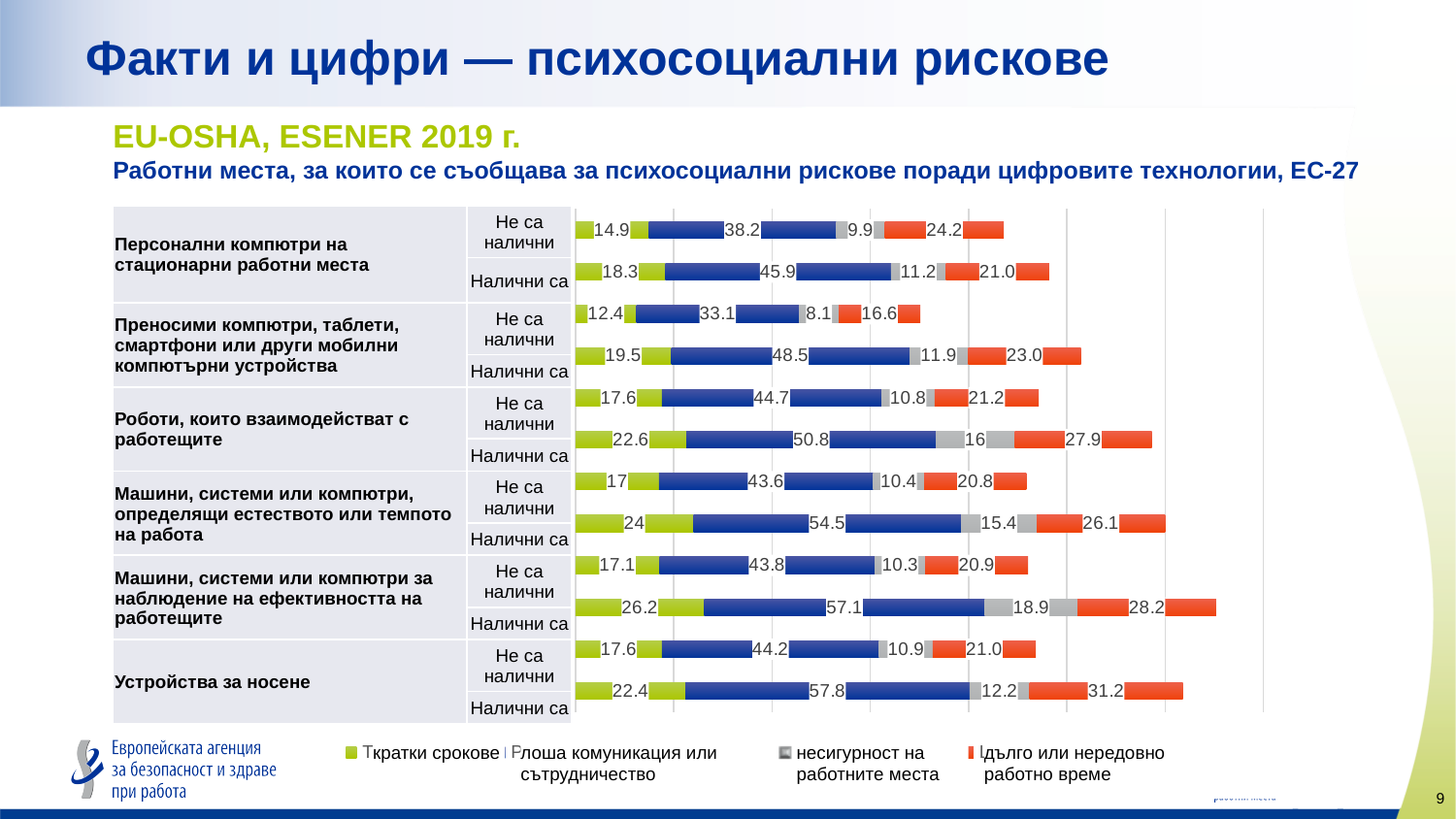
What type of chart is shown on the slide? stacked horizontal bar chart What is the value for 'дълго или нередовно работно време' in the 'Налични са' bar for 'Роботи, които взаимодействат с работещите'? 27.9 What is the value for 'несигурност на работните места' in the 'Налични са' bar for 'Машини, системи или компютри за наблюдение на ефективността на работещите'? 18.9 How many technology categories are shown on the chart? 6 What is the total of the 'Не са налични' stacked bar for 'Преносими компютри, таблети, смартфони или други мобилни компютърни устройства'? 70.2 What is the value for 'кратки срокове' in the 'Налични са' bar for 'Устройства за носене'? 22.4 Which is larger: the 'кратки срокове' value for 'Налични са' in 'Машини, системи или компютри, определящи естеството или темпото на работа' or in 'Роботи, които взаимодействат с работещите'? Машини, системи или компютри, определящи естеството или темпото на работа (24) What is the difference between the 'дълго или нередовно работно време' values for 'Налични са' and 'Не са налични' in 'Устройства за носене'? 10.2 Which bar has the lowest value for 'кратки срокове'? Преносими компютри, таблети, смартфони или други мобилни компютърни устройства, Не са налични (12.4) Which bar has the highest value for 'лоша комуникация или сътрудничество'? Устройства за носене, Налични са (57.8) How many series does the legend list? 4 What is the value for 'лоша комуникация или сътрудничество' in the 'Не са налични' bar for 'Персонални компютри на стационарни работни места'? 38.2